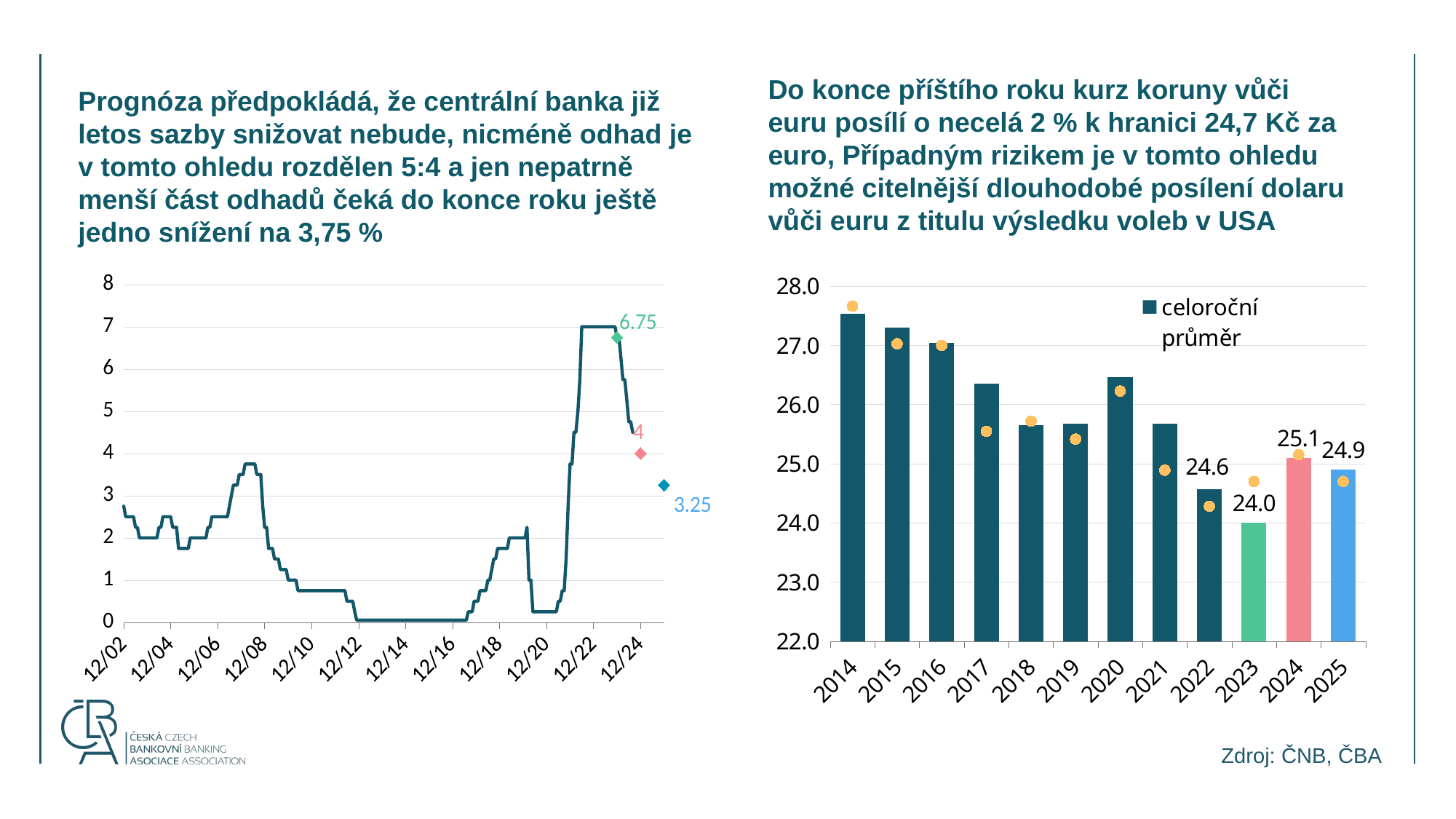
In the right-hand bar chart, what is the value shown for 2023? 24.0 In the left-hand line chart, what value is labelled at the blue diamond marker? 3.25 In the right-hand bar chart, what is the difference between the values for 2024 and 2023? 1.1 What kind of chart is the chart on the left side of the slide? line chart In the left-hand line chart, what value is labelled at the green diamond marker? 6.75 In the right-hand bar chart, is the value for 2020 greater or less than 26.0? greater In the right-hand bar chart, how many years are shown on the x axis? 12 In the right-hand bar chart, what is the value shown for 2022? 24.6 In the right-hand bar chart, what is the value shown for 2024? 25.1 In the right-hand bar chart, what is the value shown for 2025? 24.9 What kind of chart is the chart on the right side of the slide? bar chart In the right-hand bar chart, which year has the lowest bar? 2023